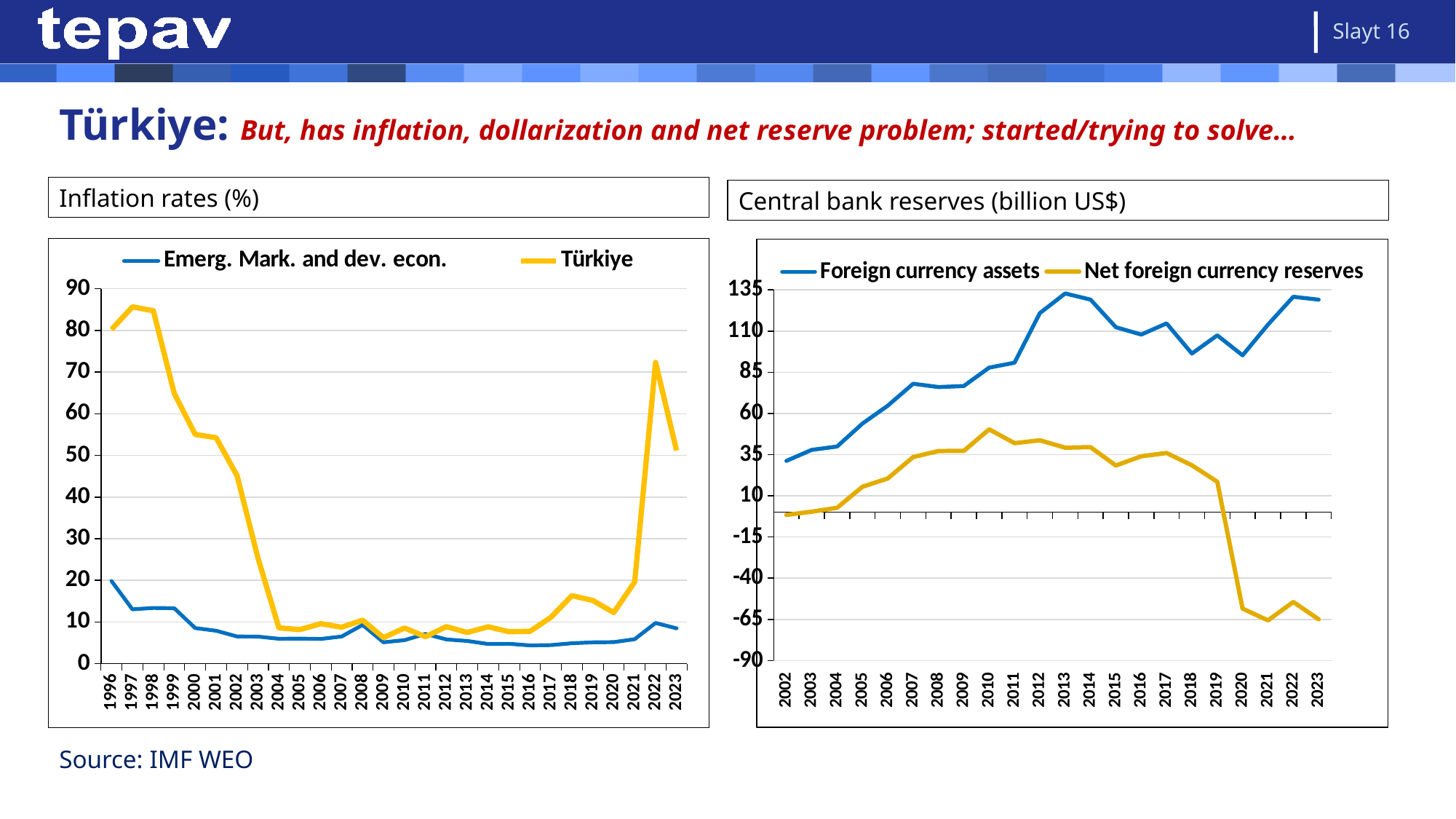
In the 'Inflation rates (%)' chart, is the Emerg. Mark. and dev. econ. value for 1996 greater or less than 30? less In the 'Central bank reserves (billion US$)' chart, is the Net foreign currency reserves value for 2020 greater or less than -40? less In the 'Inflation rates (%)' chart, is the Türkiye value for 2022 greater or less than 60? greater How many years are shown on the x axis of the 'Inflation rates (%)' chart? 28 In the 'Inflation rates (%)' chart, in which year is the Türkiye series highest? 1997 How many series does the legend of the 'Central bank reserves (billion US$)' chart list? 2 How many years are shown on the x axis of the 'Central bank reserves (billion US$)' chart? 22 In the 'Central bank reserves (billion US$)' chart, in which year is the Net foreign currency reserves series highest? 2010 What kind of chart is the 'Inflation rates (%)' chart? line chart How many series does the legend of the 'Inflation rates (%)' chart list? 2 In the 'Inflation rates (%)' chart, which series is higher in 2000, Türkiye or Emerg. Mark. and dev. econ.? Türkiye In the 'Inflation rates (%)' chart, does the Türkiye series rise or fall between 1999 and 2004? fall